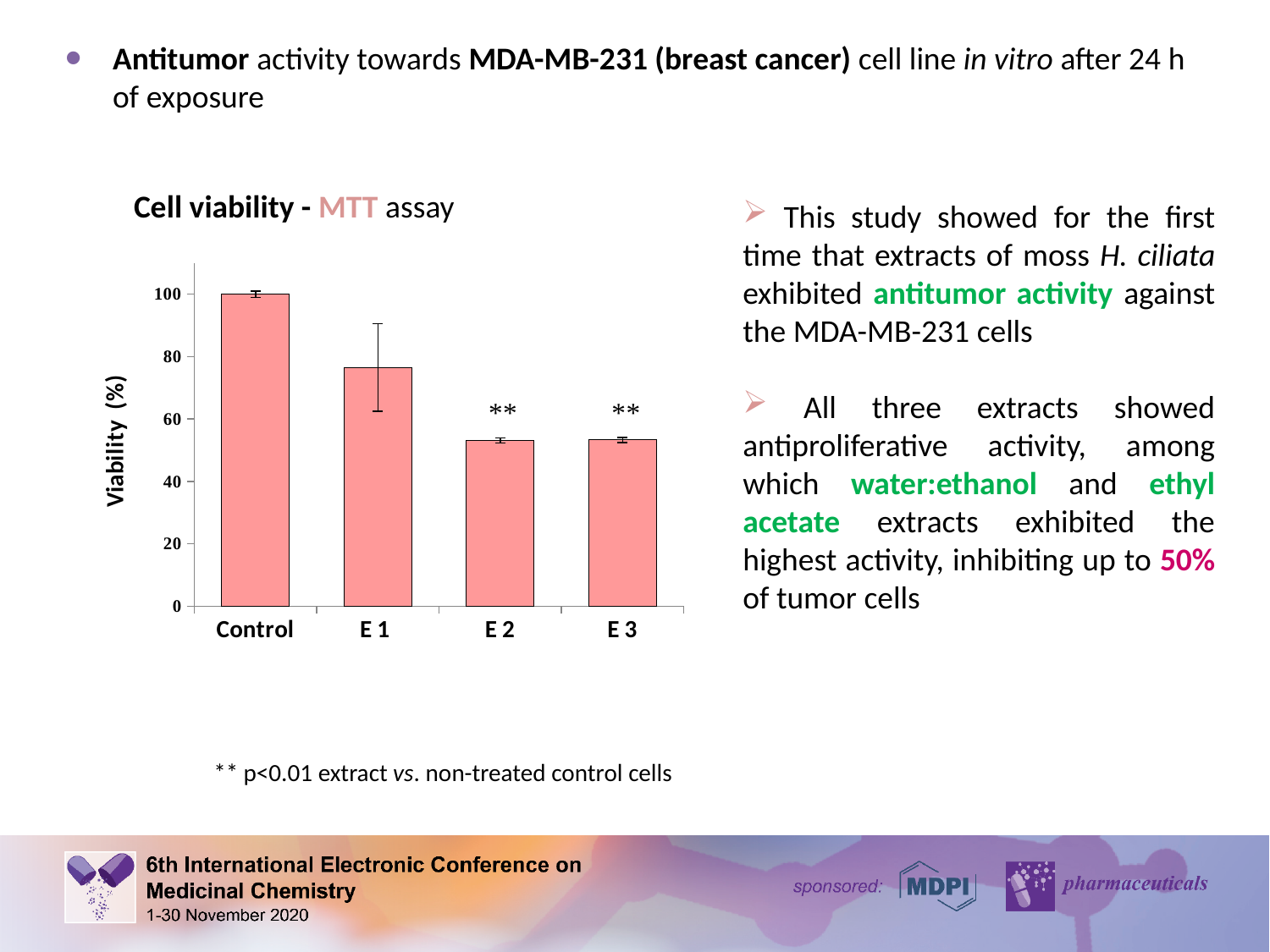
Which categories in the chart are marked with ** (p<0.01)? E 2 and E 3 How many categories are plotted on the x axis of the chart? 4 Is the viability value for E 1 greater or less than 80? less Which has a higher viability, Control or E 1? Control Is the viability value for E 2 greater or less than 60? less What is the label of the y axis of the chart? Viability (%) Which category has the highest viability in the chart? Control What kind of chart is shown on the slide? bar chart Which has a higher viability, E 1 or E 2? E 1 Is the viability value for E 3 greater or less than 40? greater What is the viability (%) value for Control? 100